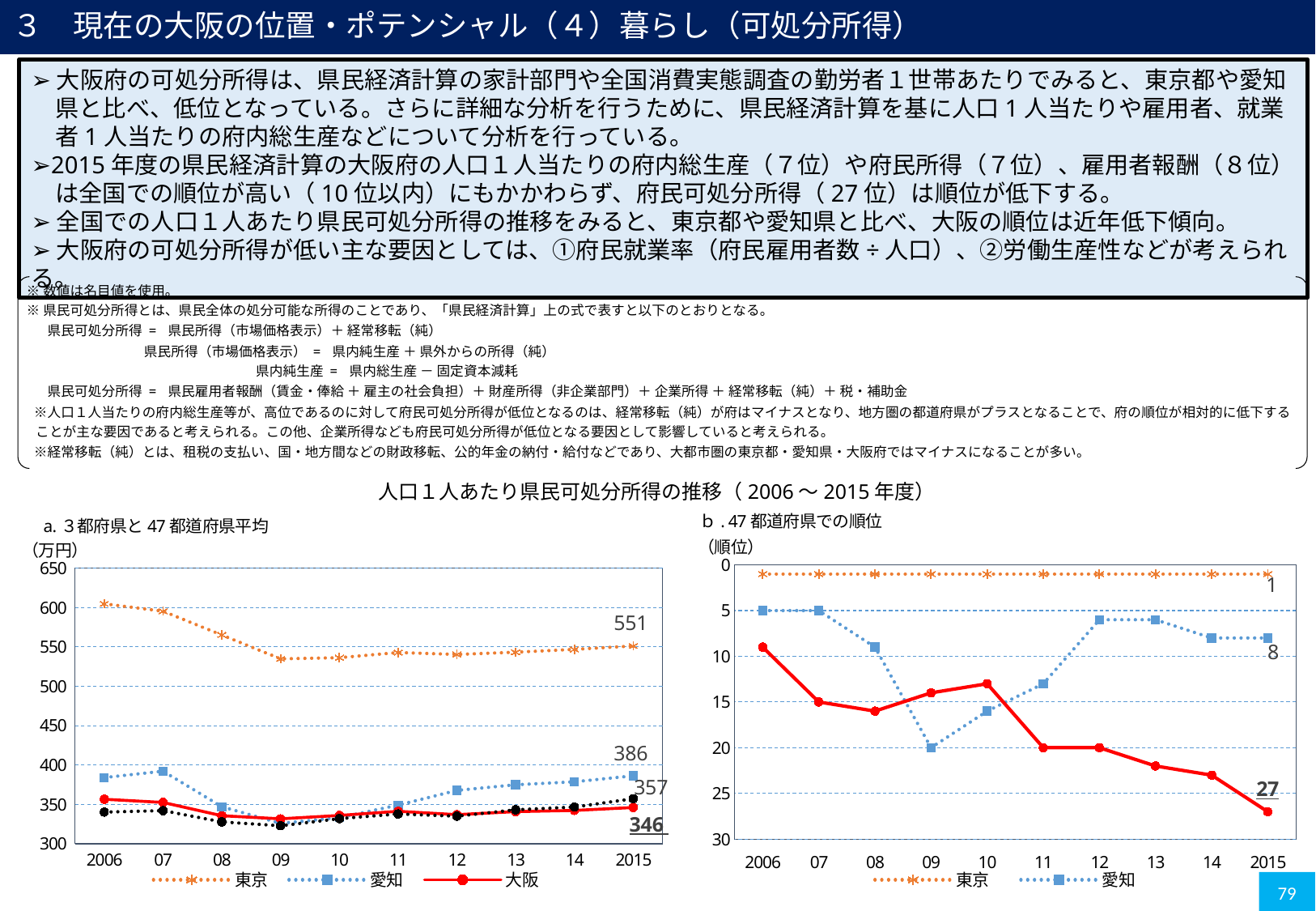
In chart a (３都府県と47都道府県平均), what is the value for 東京 in 2015? 551 In chart a (３都府県と47都道府県平均), is the value for 大阪 in 2006 greater or less than 400? less In chart a (３都府県と47都道府県平均), what is the value for 愛知 in 2015? 386 In chart a (３都府県と47都道府県平均), what is the difference between the 2015 values for 東京 and 大阪? 205 In chart b (47都道府県での順位), what is the rank for 愛知 in 2015? 8 How many series does the legend of chart b (47都道府県での順位) list? 2 In chart a (３都府県と47都道府県平均), which series has the highest value in 2015? 東京 What kind of chart is chart a (３都府県と47都道府県平均)? line chart In chart a (３都府県と47都道府県平均), how many years are plotted on the x axis? 10 How many series does the legend of chart a (３都府県と47都道府県平均) list? 3 In chart b (47都道府県での順位), what is the rank for 大阪 in 2015? 27 In chart a (３都府県と47都道府県平均), what is the value for 大阪 in 2015? 346